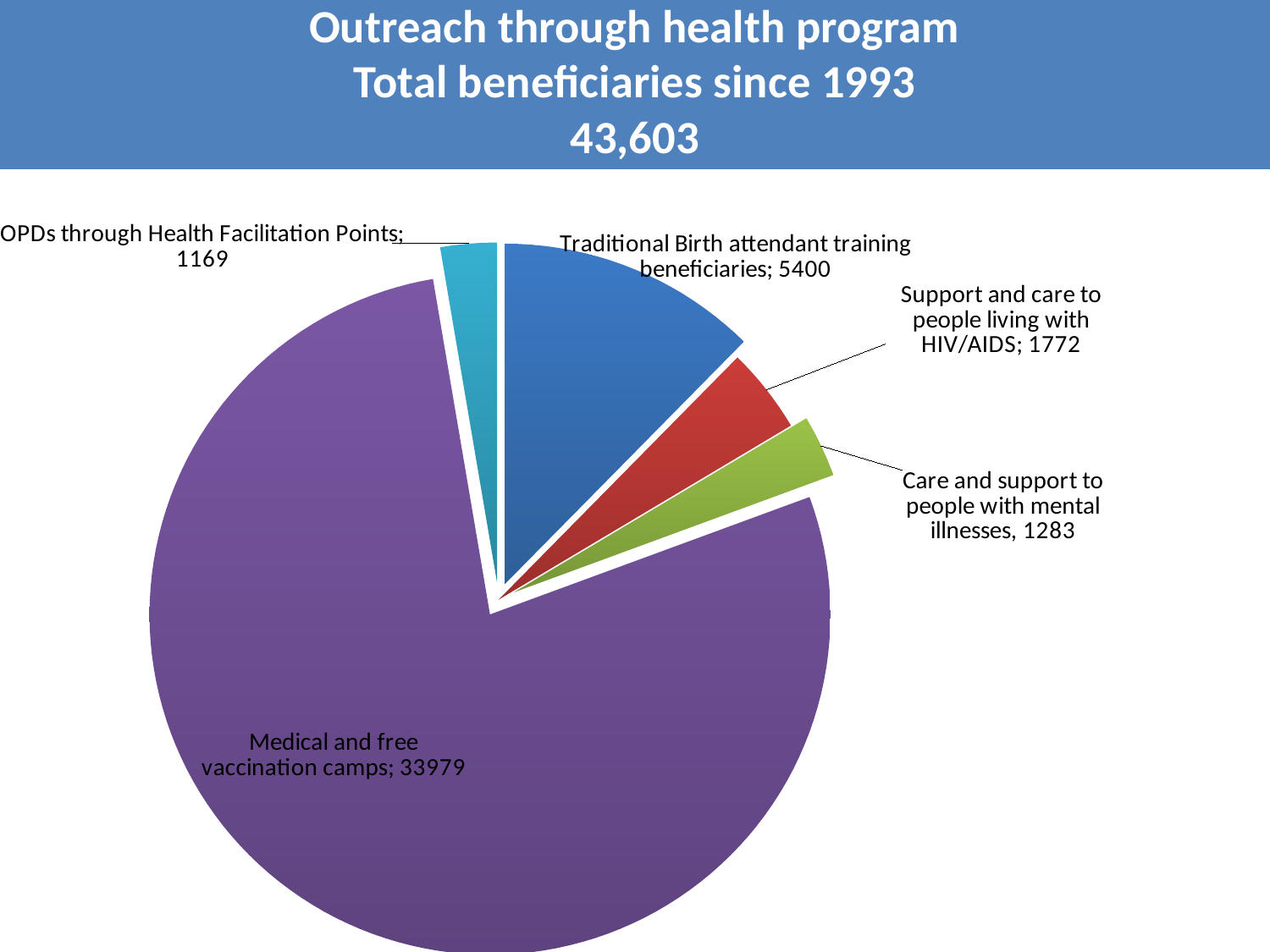
What type of chart is shown on the slide? Pie chart What is the total number of beneficiaries since 1993 stated in the slide title? 43,603 What is the value for Support and care to people living with HIV/AIDS? 1772 What share of the total beneficiaries does Medical and free vaccination camps represent? 77.9% What is the value for Traditional Birth attendant training beneficiaries? 5400 Which is larger: Support and care to people living with HIV/AIDS or Care and support to people with mental illnesses? Support and care to people living with HIV/AIDS What is the value for Medical and free vaccination camps? 33979 How many slices does the pie chart have? 5 What is the value for OPDs through Health Facilitation Points? 1169 What is the difference between the values for Traditional Birth attendant training beneficiaries and Support and care to people living with HIV/AIDS? 3628 Which category has the smallest slice of the pie? OPDs through Health Facilitation Points Which category has the largest slice of the pie? Medical and free vaccination camps